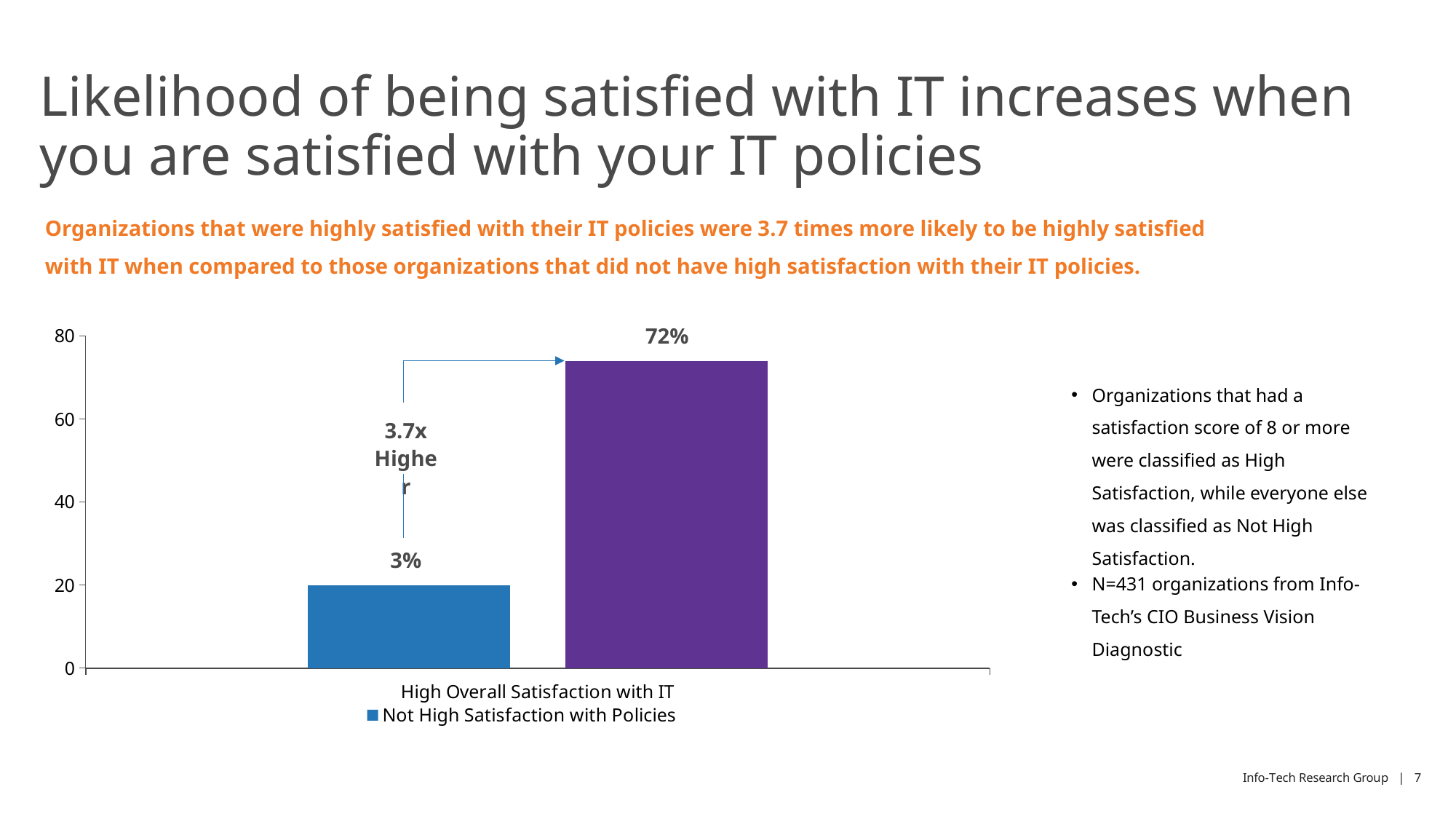
What kind of chart is shown on the slide? bar chart What is the highest value shown on the vertical axis? 80 Is the purple bar's height greater or less than 60 on the vertical axis? greater What data label is printed above the blue bar? 3% What category label appears below the bars on the horizontal axis? High Overall Satisfaction with IT Which bar is taller, the blue bar or the purple bar? the purple bar Is the blue bar's height greater or less than 40 on the vertical axis? less What data label is printed above the purple bar? 72% What multiplier is annotated between the two bars? 3.7x Higher Which series does the legend entry with the blue marker refer to? Not High Satisfaction with Policies How many bars are plotted in the chart? 2